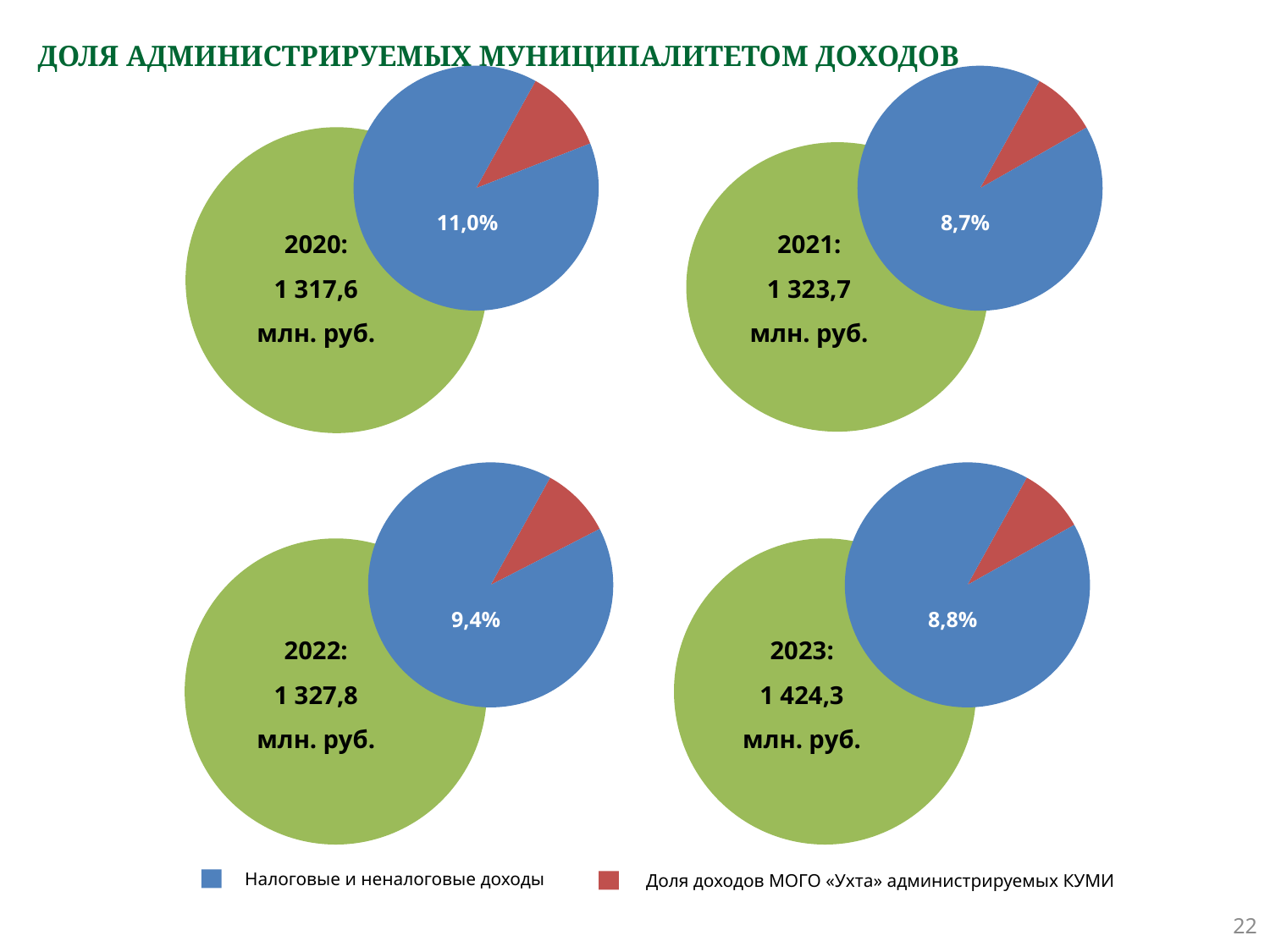
In the 2021 pie chart, what share is shown for the red slice (Доля доходов МОГО «Ухта» администрируемых КУМИ)? 8,7% Which year's pie chart shows the highest KUMI-administered share? 2020 How many pie charts are on the slide? 4 In the 2020 pie chart, what share of revenues is administered by KUMI (the red slice)? 11,0% Is the KUMI-administered share larger in 2022 or in 2023? 2022 How many entries does the legend at the bottom of the slide list? 2 In the 2022 pie chart, what percentage is printed for the KUMI-administered share? 9,4% What is the difference between the KUMI-administered share in 2020 and in 2021? 2,3% What total revenue is shown in the green circle for 2020? 1 317,6 млн. руб. What total revenue (in млн. руб.) is shown in the green circle for 2023? 1 424,3 млн. руб. Which year's pie chart shows the lowest KUMI-administered share? 2021